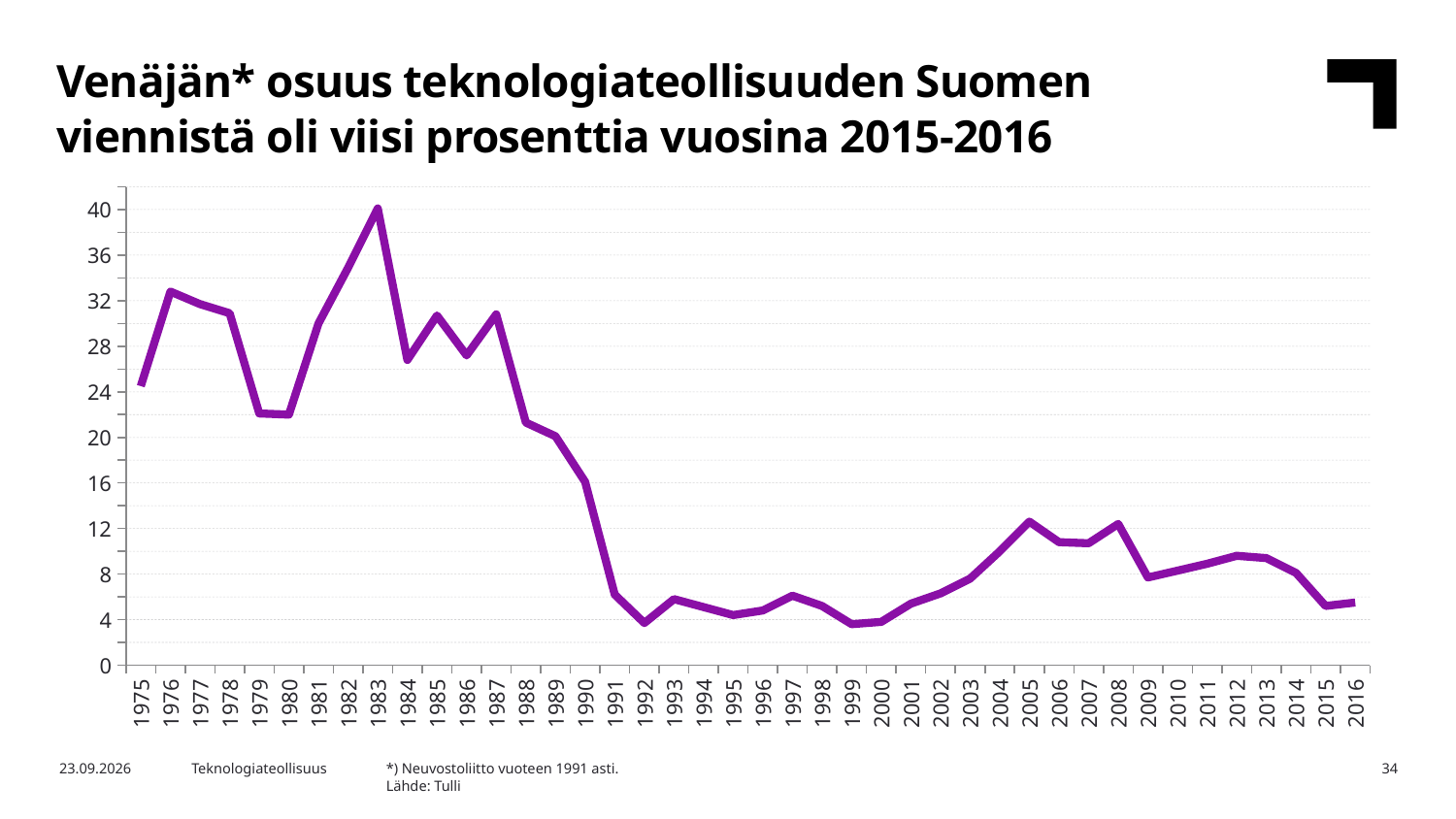
What source is cited at the bottom of the slide for the chart data? Tulli Is the value for 2012 greater or less than 8? greater Which year has the larger value, 1983 or 1985? 1983 Does the line rise or fall between 1983 and 1992? fall How many years (data points) are plotted along the x axis? 42 In which year does the line reach its highest value? 1983 Is the value for 1983 greater or less than 36? greater What kind of chart is shown on the slide? line chart Is the value for 1991 greater or less than 8? less Which year has the larger value, 2005 or 2015? 2005